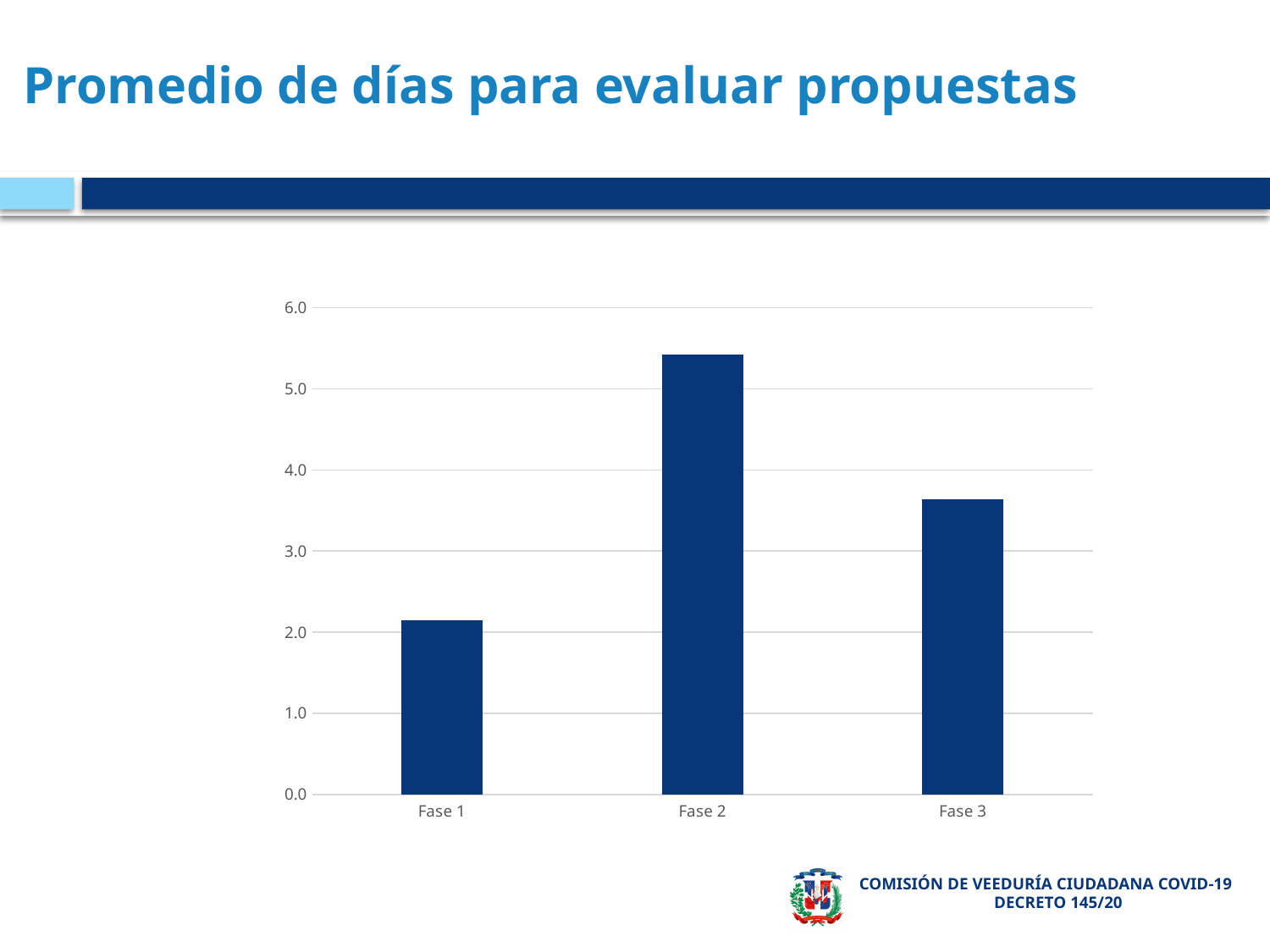
Which has a larger value, Fase 1 or Fase 3? Fase 3 Is the value for Fase 3 greater or less than 4.0? less Does the value rise or fall from Fase 2 to Fase 3? fall Is the value for Fase 2 greater or less than 5.0? greater Is the value for Fase 1 greater or less than 3.0? less How many categories are shown on the x axis of the chart? 3 Which category has the lowest value in the chart? Fase 1 Does the value rise or fall from Fase 1 to Fase 2? rise Which has a larger value, Fase 2 or Fase 3? Fase 2 What kind of chart is shown on the slide? bar chart Which category has the highest value in the chart? Fase 2 What is the title of the chart on the slide? Promedio de días para evaluar propuestas